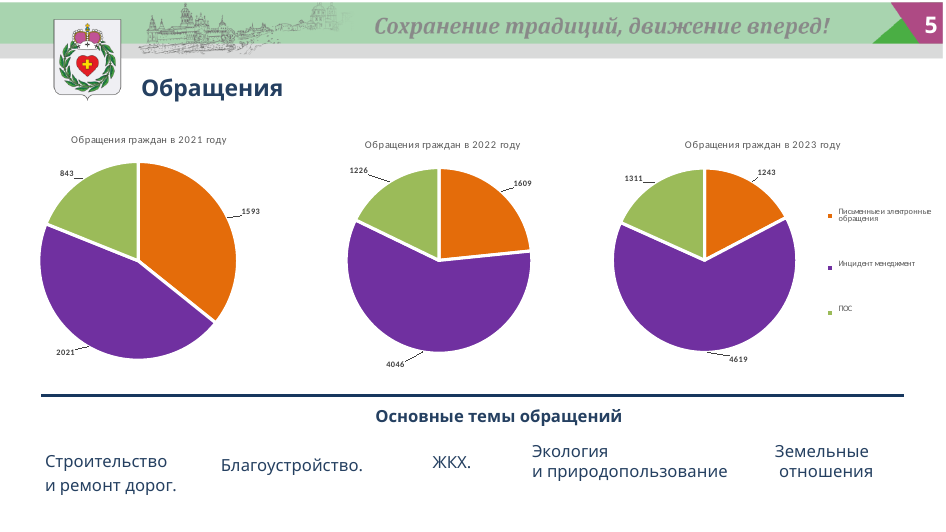
How many slices does the chart "Обращения граждан в 2022 году" have? 3 In the chart "Обращения граждан в 2023 году", what is the value for Письменные и электронные обращения? 1243 In the chart "Обращения граждан в 2023 году", what is the total of all three slices? 7173 In the chart "Обращения граждан в 2022 году", what is the difference between Инцидент менеджмент and Письменные и электронные обращения? 2437 In the chart "Обращения граждан в 2022 году", what is the value for ПОС? 1226 In the chart "Обращения граждан в 2021 году", which category has the smallest slice? ПОС What kind of chart is "Обращения граждан в 2021 году"? pie chart How many pie charts are shown on the slide? 3 In the chart "Обращения граждан в 2021 году", which is larger: Письменные и электронные обращения or ПОС? Письменные и электронные обращения In the chart "Обращения граждан в 2021 году", what is the value for Инцидент менеджмент? 2021 In the chart "Обращения граждан в 2023 году", which category has the largest slice? Инцидент менеджмент How many entries does the legend on the slide list? 3